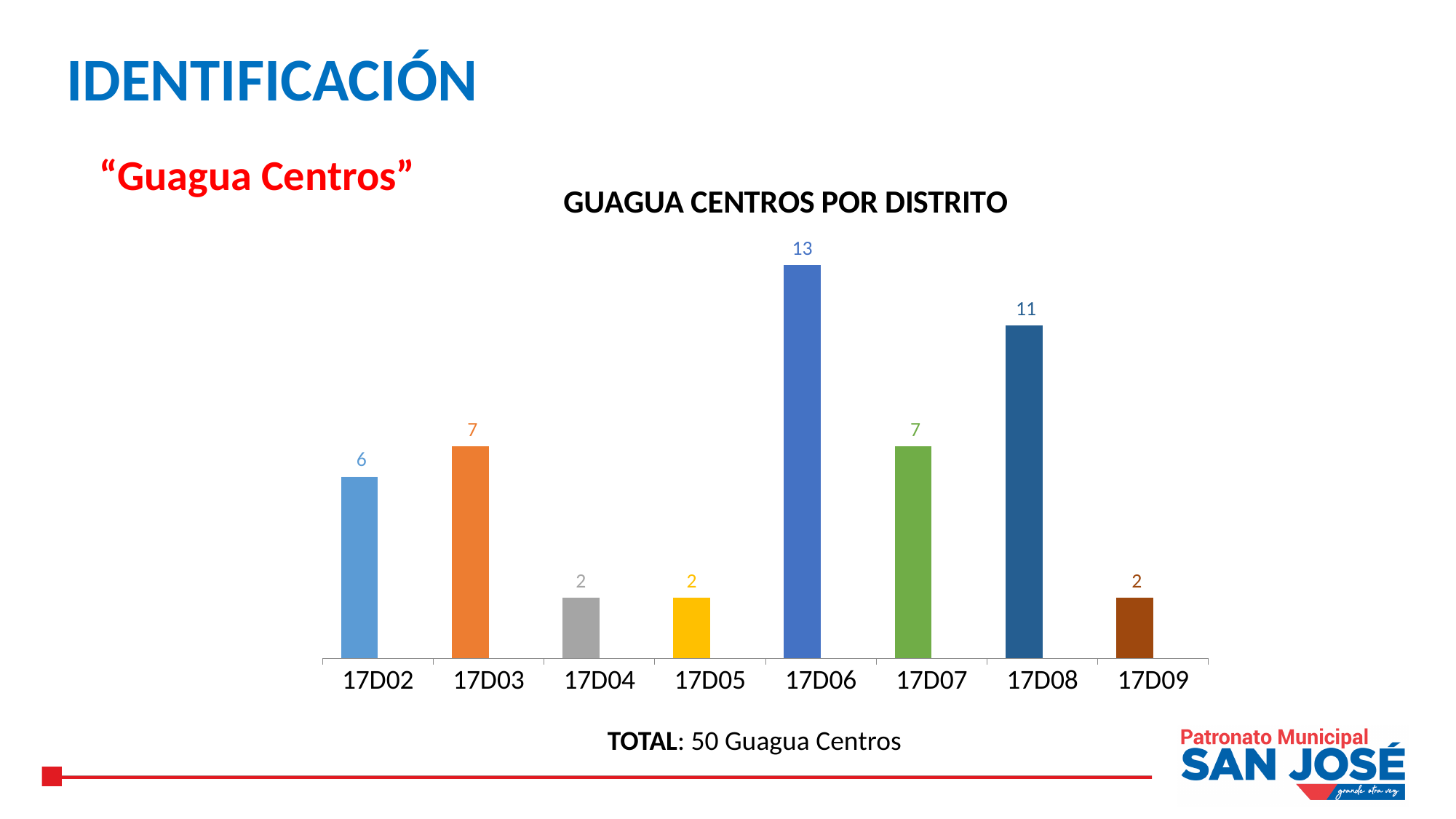
What is the title of the chart? GUAGUA CENTROS POR DISTRITO What is the difference between the values for 17D03 and 17D02? 1 What total is stated below the chart? 50 Guagua Centros What is the difference between the values for 17D06 and 17D08? 2 What is the value for 17D02? 6 What kind of chart is shown on the slide? Bar chart Which district has the highest number of Guagua Centros? 17D06 How many districts are shown on the x axis? 8 Which is larger, the value for 17D03 or the value for 17D02? 17D03 What is the value for 17D08? 11 What is the value for 17D06? 13 How many districts have a value of 2? 3